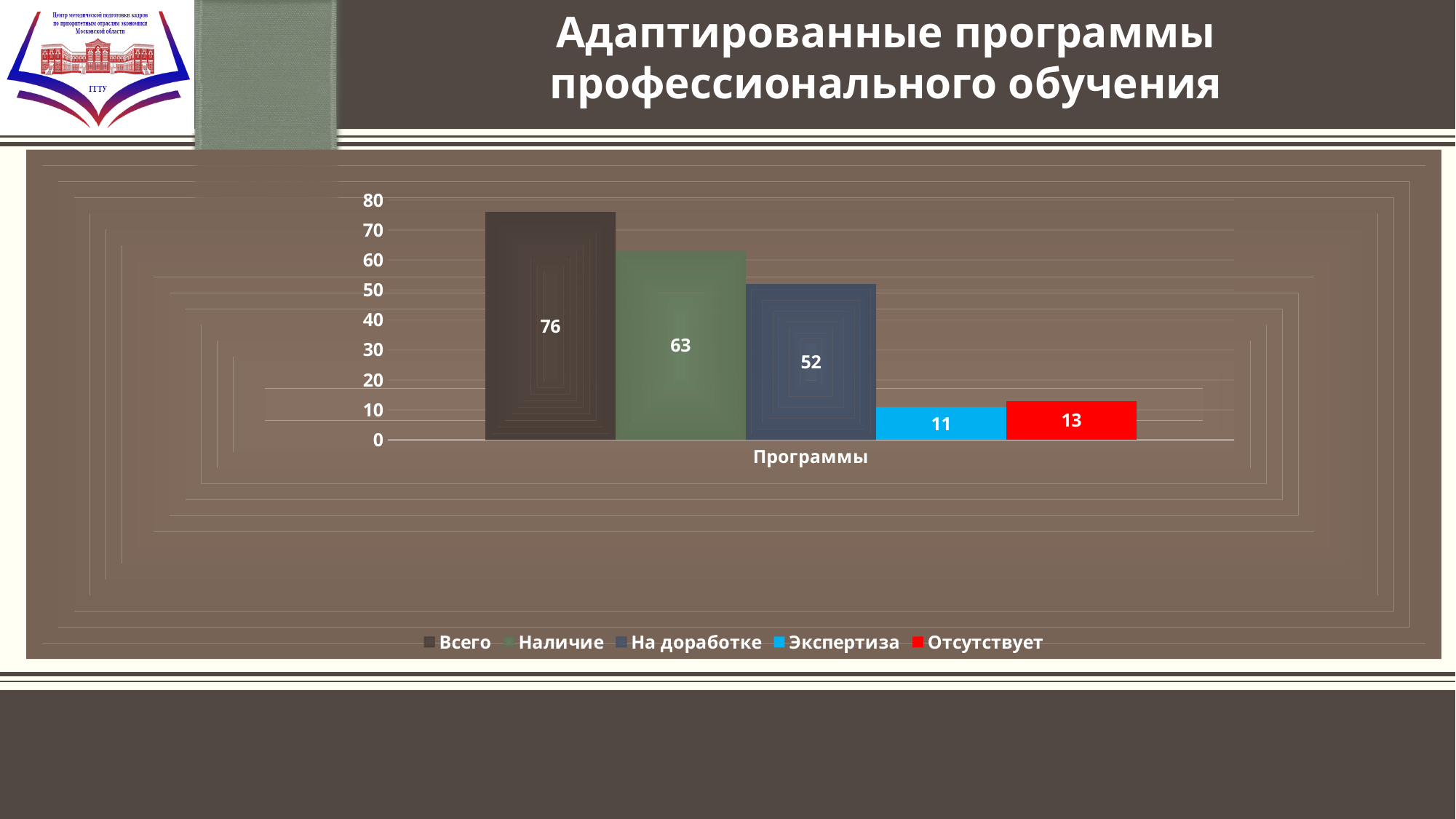
What is the difference between the values for Всего and Наличие? 13 What is the label on the x axis of the chart? Программы Which series has the highest value? Всего Which is larger, the value for На доработке or the value for Отсутствует? На доработке What is the value for Отсутствует? 13 How many series does the legend list? 5 Which series has the lowest value? Экспертиза What is the value for Наличие? 63 What is the value for На доработке? 52 What kind of chart is shown on the slide? Bar chart What is the value for Всего? 76 What is the value for Экспертиза? 11